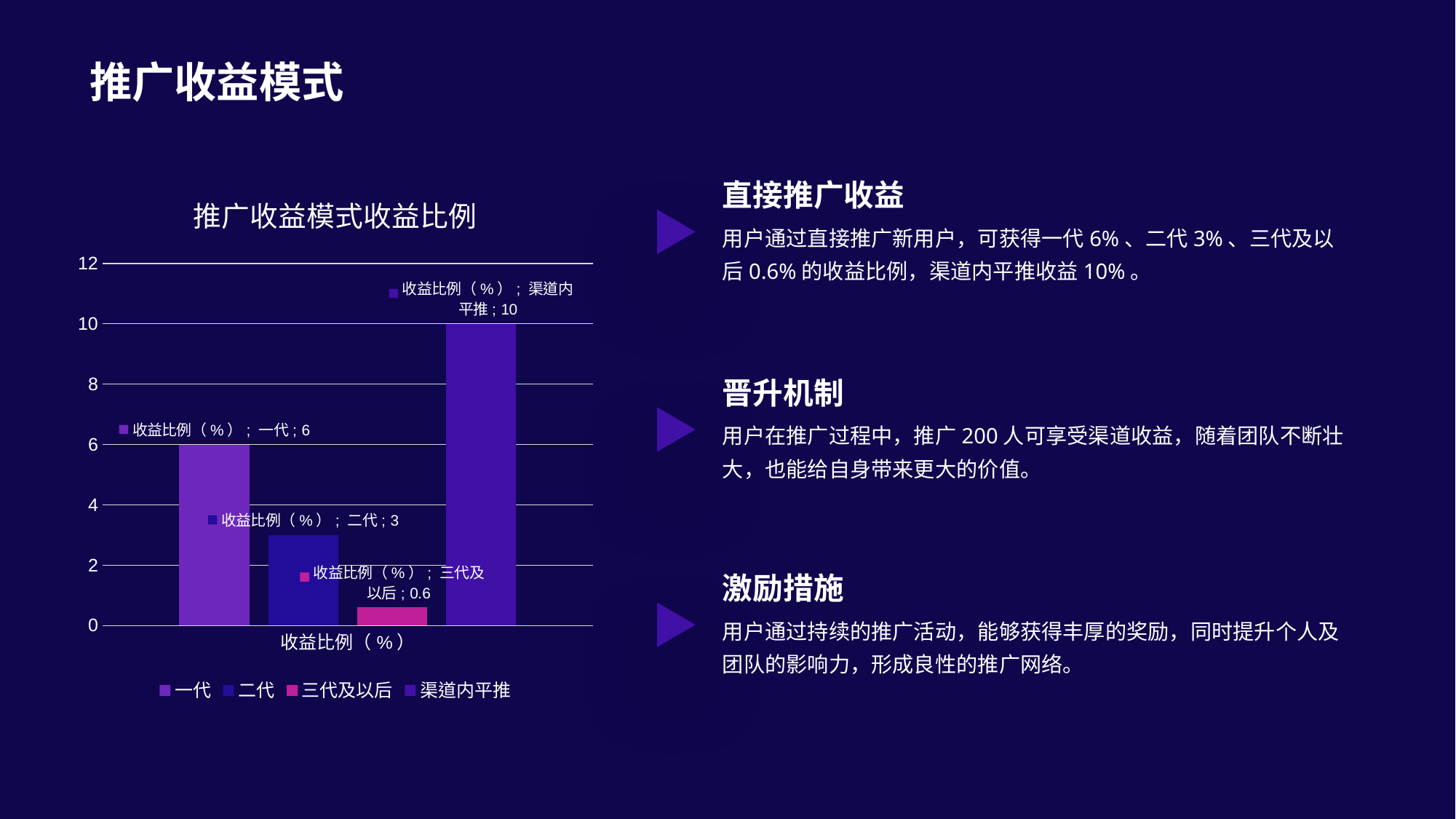
What is the value for 一代 in the chart? 6 What is the title of the chart? 推广收益模式收益比例 What is the value for 二代 in the chart? 3 How many series does the legend list? 4 What is the difference between the values for 渠道内平推 and 一代? 4 What is the difference between the values for 一代 and 二代? 3 What kind of chart is shown on the slide? Bar chart What is the value for 三代及以后 in the chart? 0.6 Which series has the lowest value in the chart? 三代及以后 Which is larger, the value for 一代 or the value for 二代? 一代 Which series has the highest value in the chart? 渠道内平推 What is the value for 渠道内平推 in the chart? 10